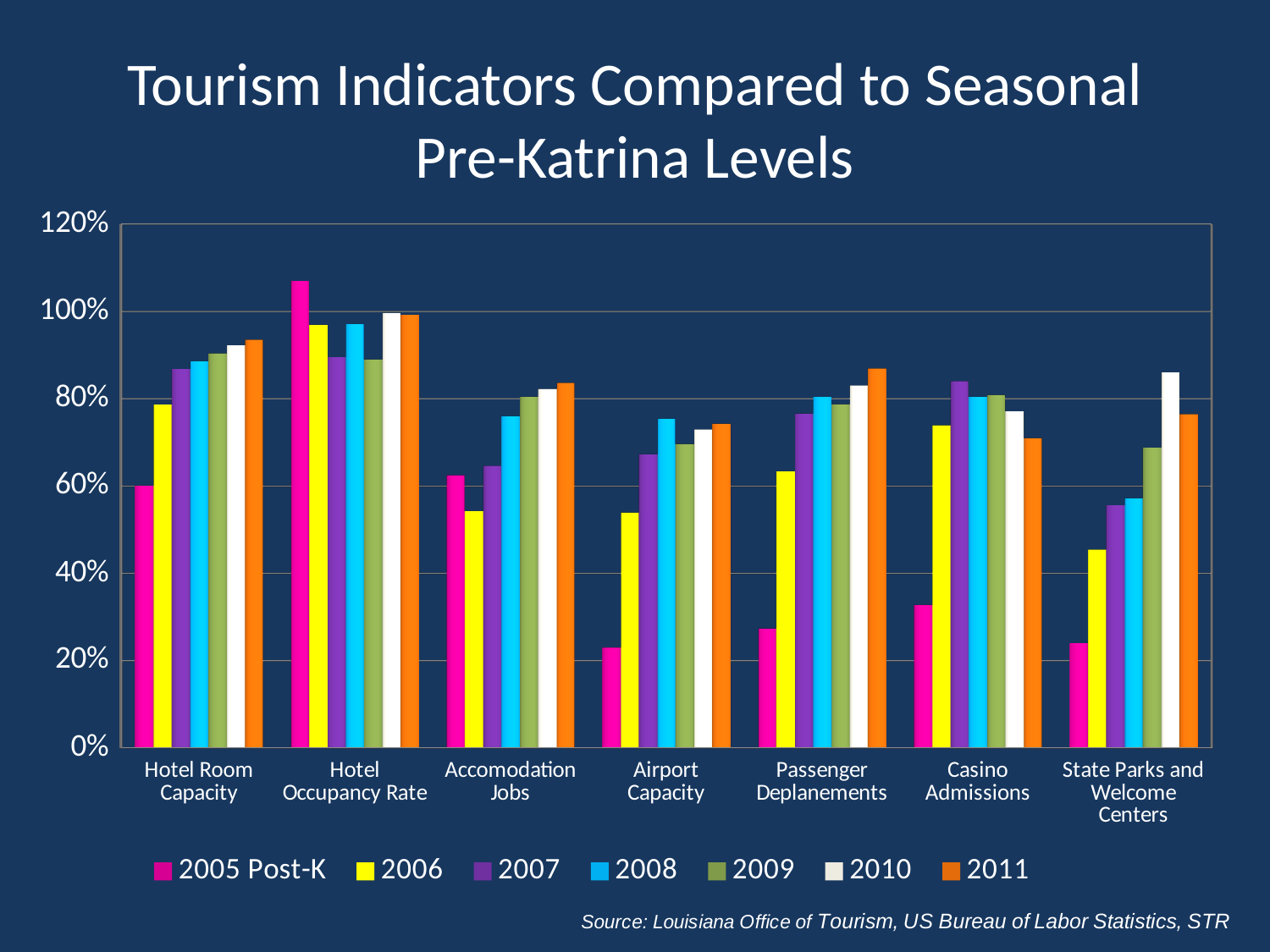
What kind of chart is shown on the slide? Bar chart For Hotel Room Capacity, which is larger: the 2005 Post-K value or the 2011 value? 2011 Is the 2010 value for State Parks and Welcome Centers greater or less than 80%? greater Do the Hotel Room Capacity bars rise or fall from 2005 Post-K through 2011? rise Which category has the lowest 2006 bar? State Parks and Welcome Centers Which series has the highest bar for Passenger Deplanements? 2011 Is the 2005 Post-K value for Airport Capacity greater or less than 40%? less Which category has the highest 2005 Post-K bar? Hotel Occupancy Rate How many series does the legend list? 7 Is the 2005 Post-K value for Hotel Occupancy Rate greater or less than 100%? greater For Casino Admissions, which is larger: the 2007 value or the 2011 value? 2007 How many tourism indicator categories are shown on the x axis? 7